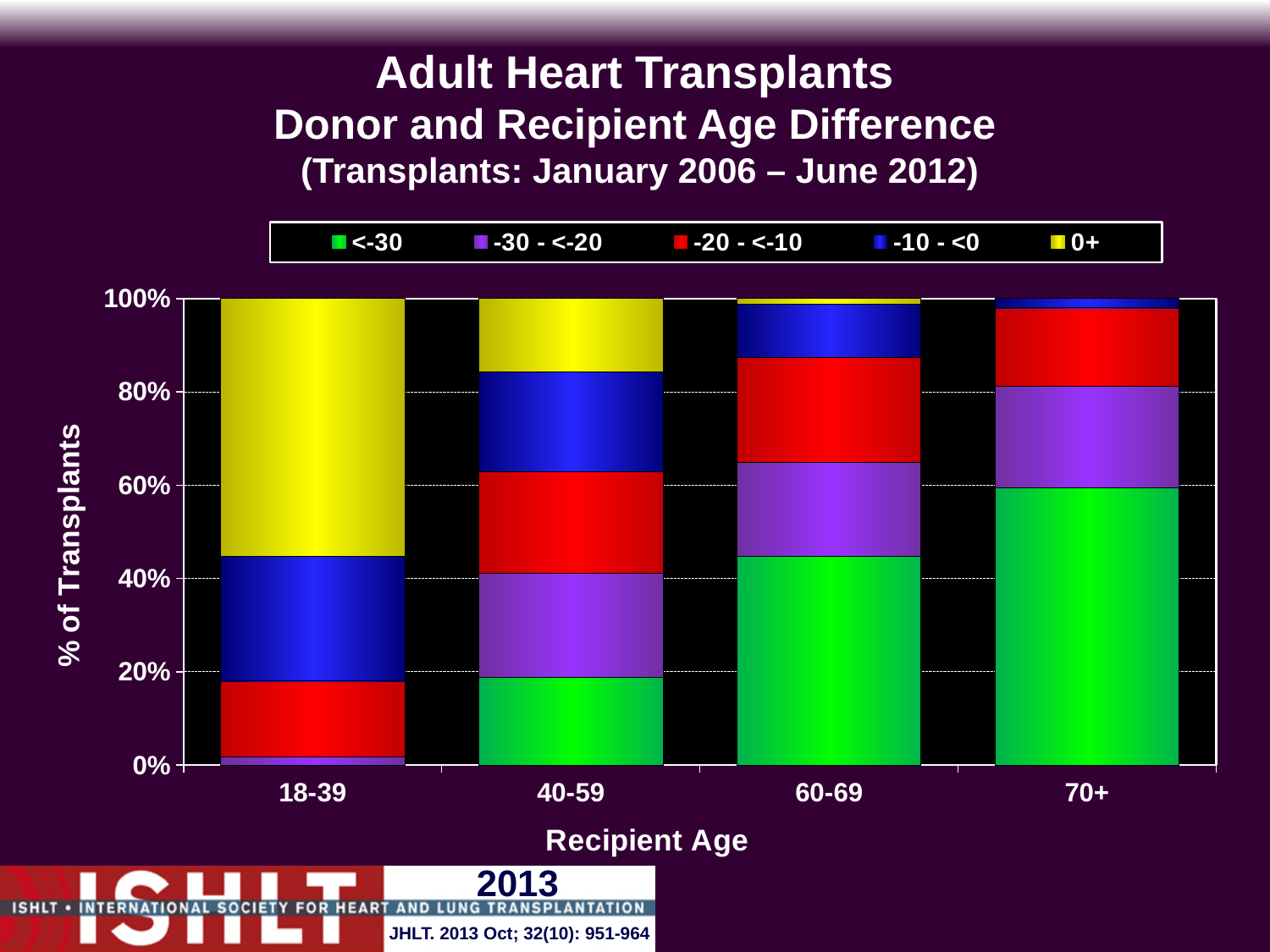
What is the title of the y axis? % of Transplants Is the share of transplants in the 0+ category for the 18-39 group greater or less than 40%? greater Does the share of transplants in the <-30 category rise or fall as recipient age increases from 18-39 to 70+? rises Which recipient age group has the smallest share of transplants in the <-30 category? 18-39 Which recipient age group has the largest share of transplants in the 0+ category? 18-39 How many series does the legend list? 5 What kind of chart is shown on the slide? Stacked bar chart Which recipient age group has the largest share of transplants in the <-30 category? 70+ How many recipient age groups are shown on the x axis? 4 Is the share of transplants in the <-30 category for the 70+ group greater or less than 40%? greater What is the title of the x axis? Recipient Age Is the share of transplants in the 0+ category larger for the 18-39 group or the 40-59 group? 18-39